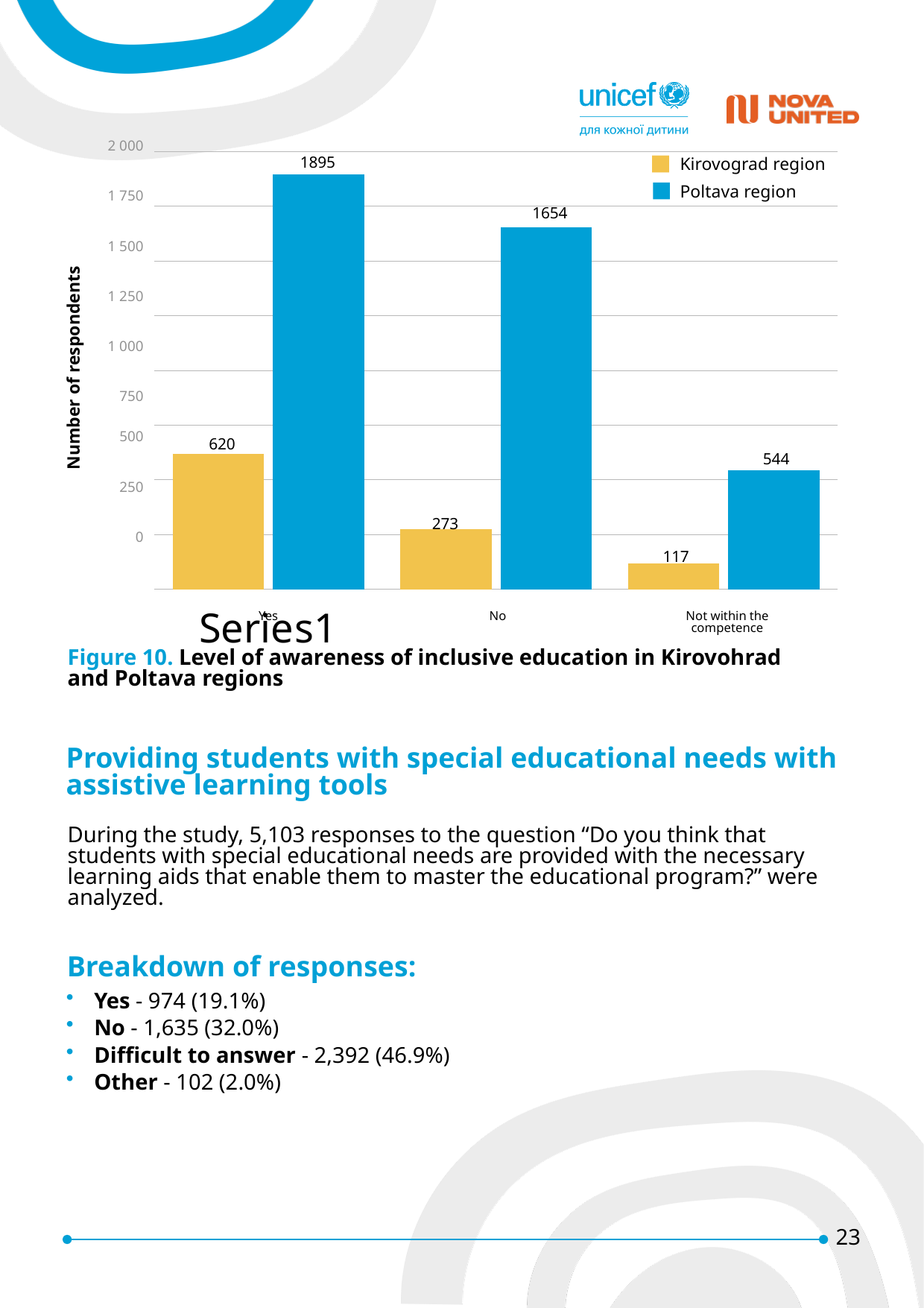
What is the difference between the Poltava region and Kirovograd region values for the 'No' category? 1381 What is the label of the y axis? Number of respondents How many categories are shown on the x axis? 3 Which region has the larger value for 'Not within the competence'? Poltava region Which category has the lowest value for the Kirovograd region? Not within the competence What is the value for the Poltava region for 'Not within the competence'? 544 Which category has the highest value for the Poltava region? Yes What is the value for the Kirovograd region for the 'Yes' category? 620 How many series does the legend list? 2 What kind of chart is shown? Bar chart What is the value for the Kirovograd region for the 'No' category? 273 What is the value for the Poltava region for the 'Yes' category? 1895